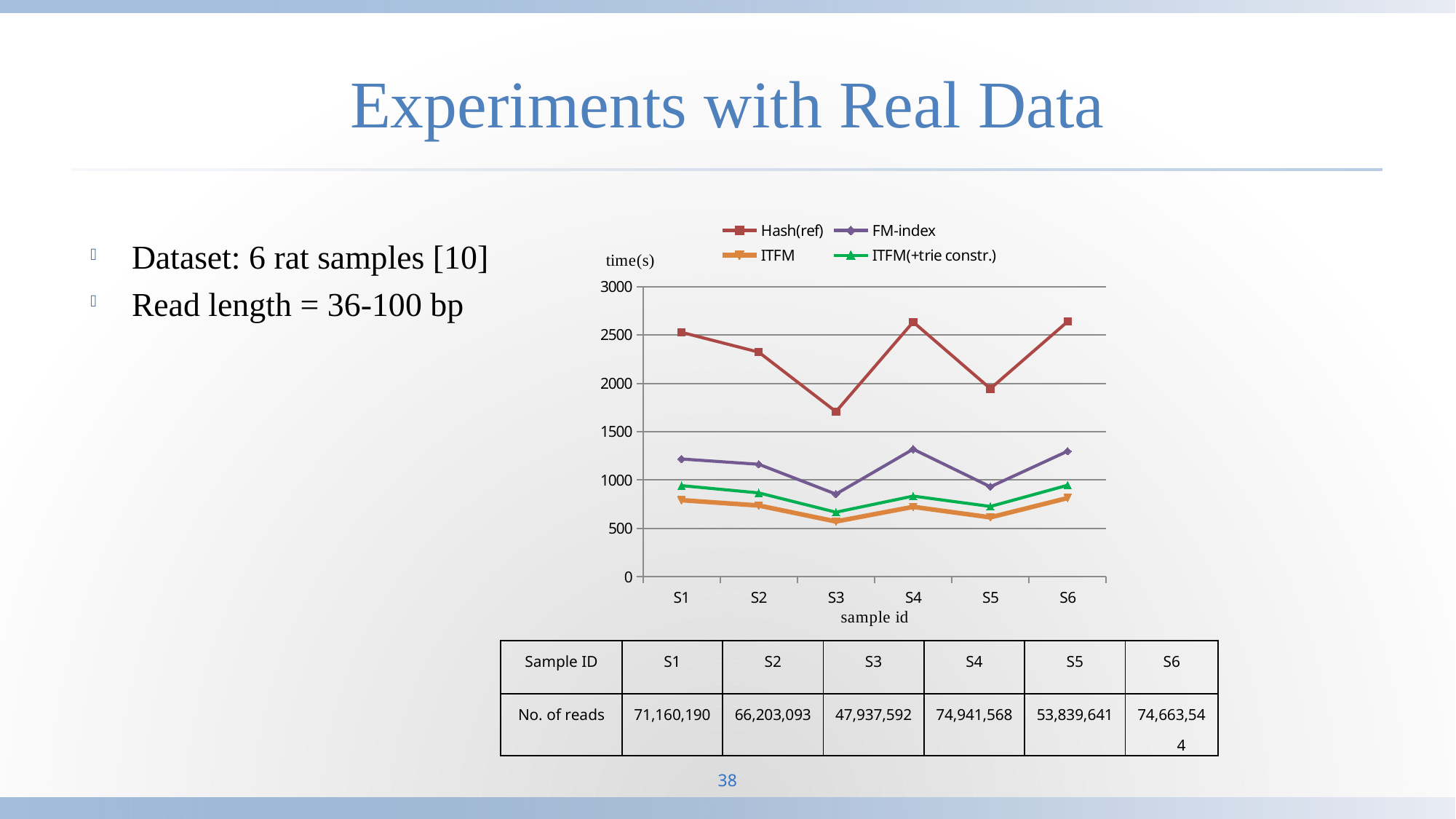
Is the Hash(ref) value for S4 greater or less than 2500? greater At S1, which series has the larger value, Hash(ref) or FM-index? Hash(ref) How many series does the chart legend list? 4 What kind of chart is shown on the slide? line chart How many sample ids are plotted along the x axis of the chart? 6 Is the Hash(ref) value for S3 greater or less than 2000? less What is the label on the y axis of the chart? time(s) At S3, which series has the larger value, ITFM or ITFM(+trie constr.)? ITFM(+trie constr.) Is the ITFM value for S3 greater or less than 500? greater For which sample id is the FM-index time lowest? S3 For which sample id is the Hash(ref) time lowest? S3